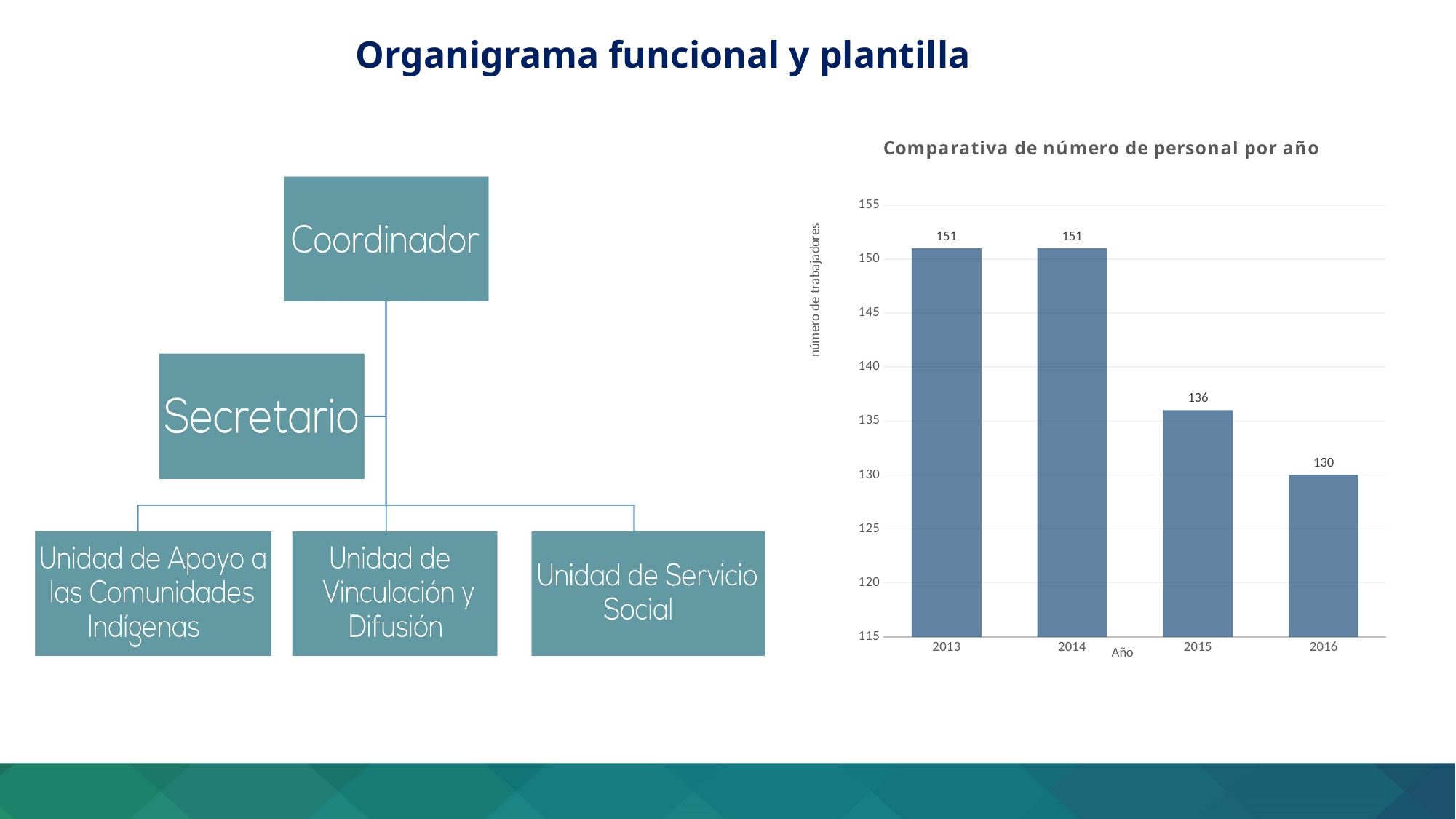
What is the difference between the values for 2015 and 2016? 6 What is the difference between the values for 2014 and 2016? 21 How many years are shown on the x axis of the chart? 4 What is the title of the chart on the slide? Comparativa de número de personal por año Is the value for 2015 greater or less than 140? less Which is larger, the value for 2015 or the value for 2016? 2015 What is the value for 2013 in the chart? 151 What is the value for 2015 in the chart? 136 Do the values in the chart rise or fall from 2014 to 2016? fall What is the value for 2016 in the chart? 130 Which year has the lowest number of workers in the chart? 2016 What kind of chart is shown on the slide? bar chart